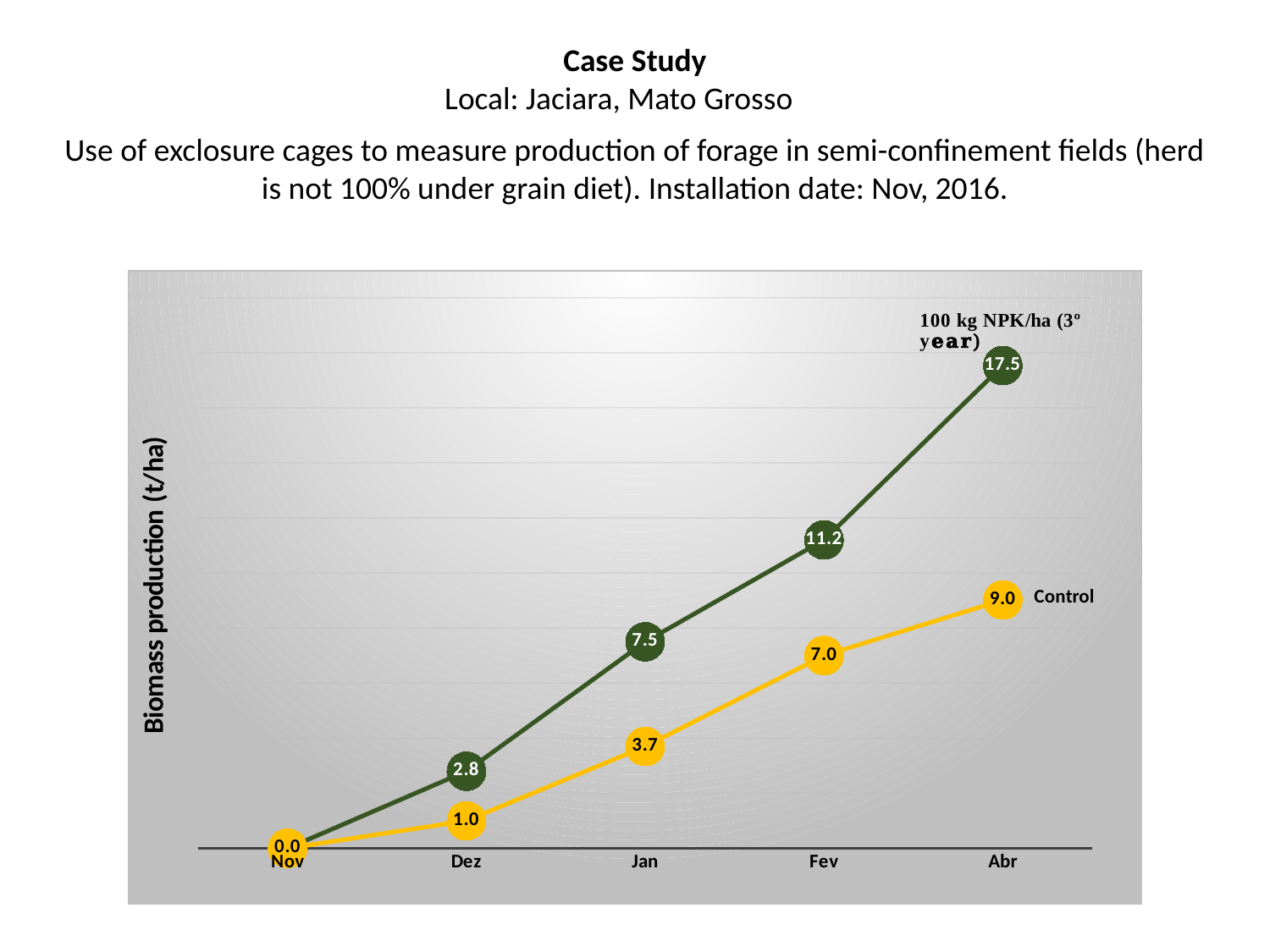
What is the difference between the 100 kg NPK/ha and Control values in Jan? 3.8 In which month does the Control series reach its highest value? Abr What is the biomass production for the Control series in Fev? 7.0 Which series has the larger value in Fev, 100 kg NPK/ha or Control? 100 kg NPK/ha What is the difference between the 100 kg NPK/ha and Control values in Abr? 8.5 What is the biomass production for the 100 kg NPK/ha series in Jan? 7.5 How many months are shown on the x axis? 5 What type of chart is shown on the slide? Line chart Do the values of the Control series rise or fall from Nov to Abr? Rise What is the biomass production for the Control series in Dez? 1.0 What is the biomass production for the 100 kg NPK/ha series in Abr? 17.5 What is the label of the y axis? Biomass production (t/ha)